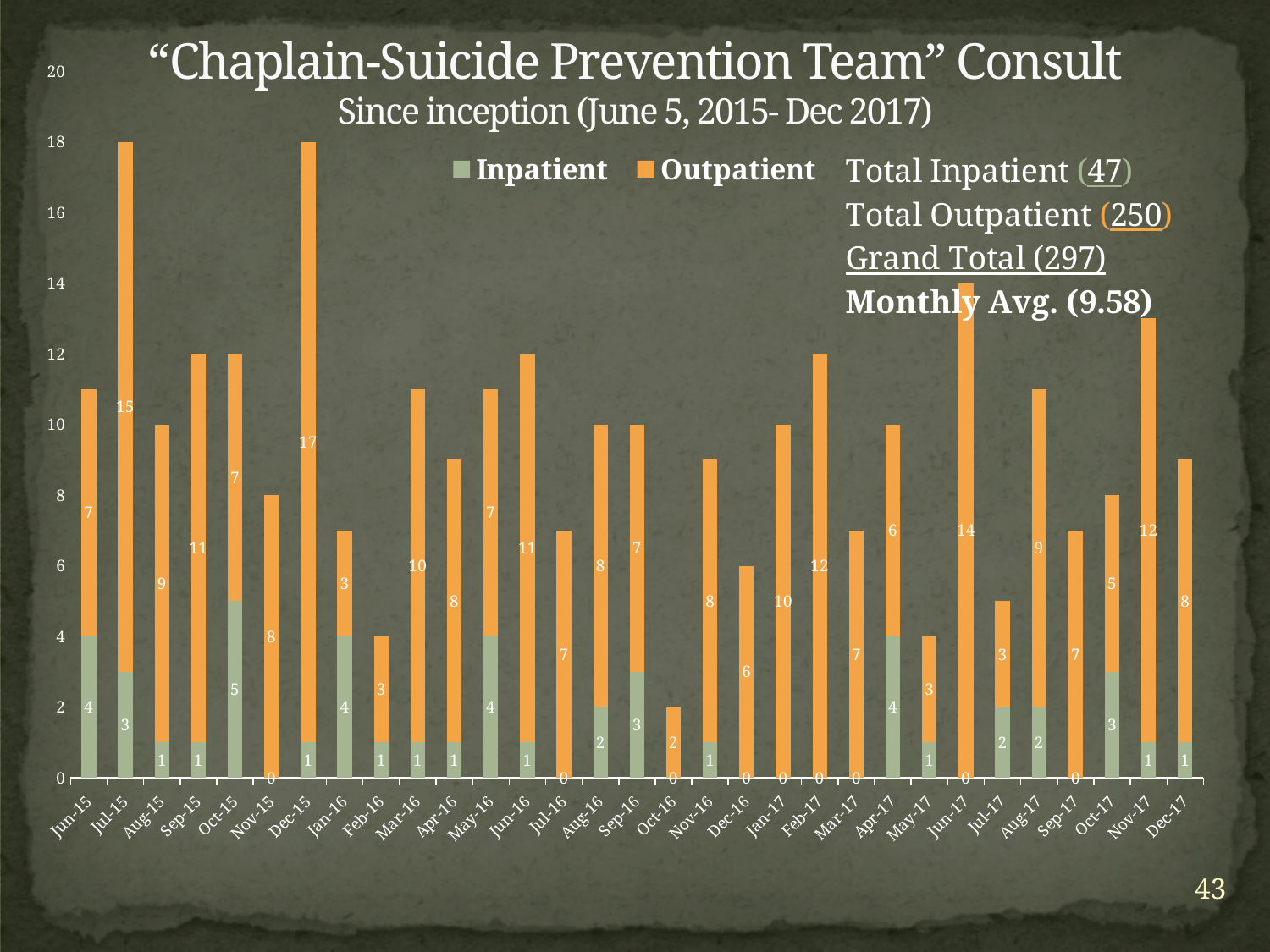
What type of chart is shown on the slide? stacked bar chart What is the Inpatient value for Oct-15? 5 What is the difference between the Outpatient values for Nov-17 and Oct-17? 7 How many months are shown on the x axis? 31 What is the total (Inpatient plus Outpatient) for Jul-15? 18 What is the Outpatient value for Dec-15? 17 Which is larger, the Inpatient value for Jan-16 or the Inpatient value for Feb-16? Jan-16 How many series does the legend list? 2 Which month has the lowest Outpatient value? Oct-16 Which month has the highest Outpatient value? Dec-15 What Grand Total is stated in the text on the slide? 297 What is the Outpatient value for Jun-17? 14